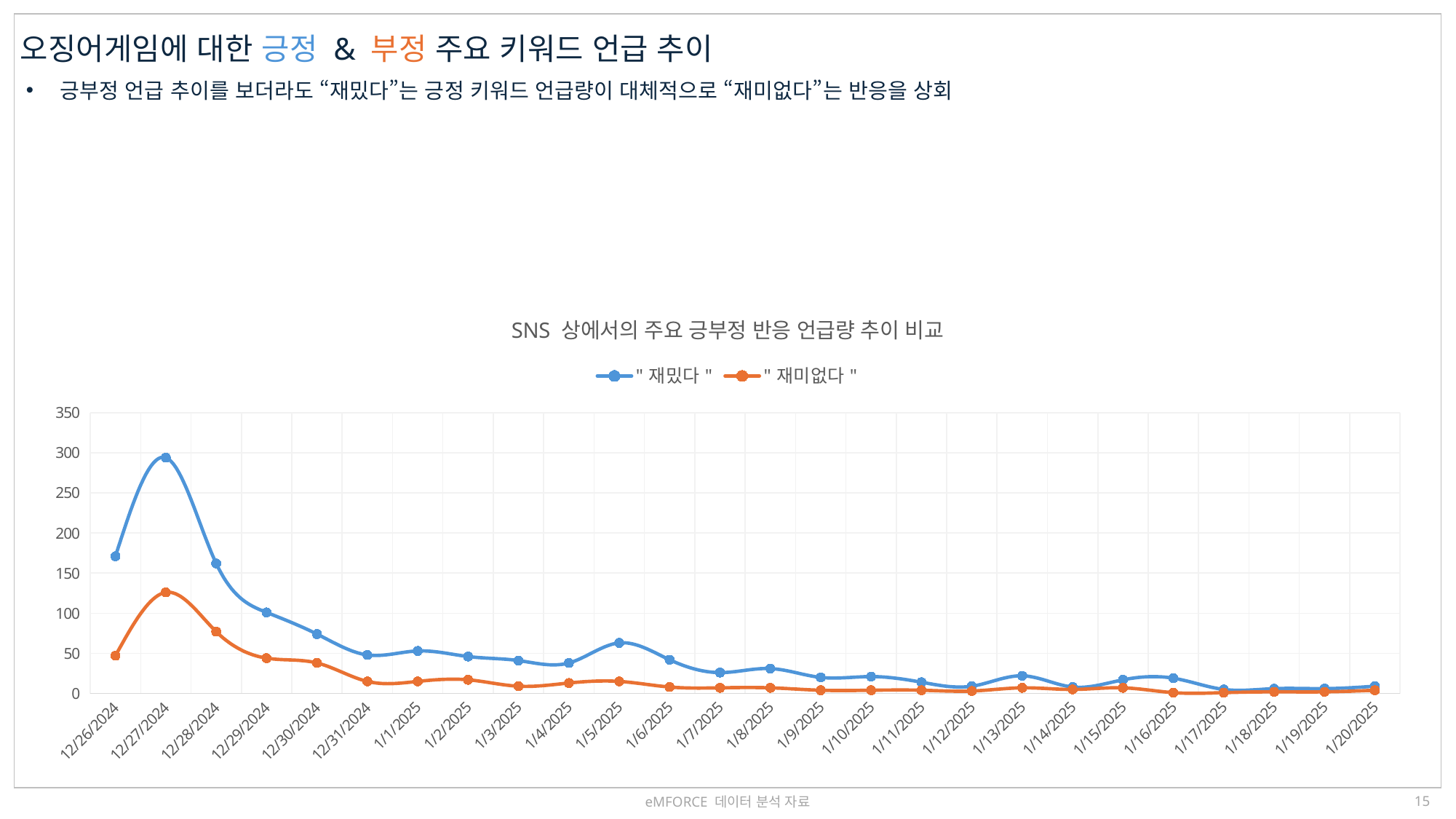
What is the title of the chart? SNS 상에서의 주요 긍부정 반응 언급량 추이 비교 Does the "재밌다" series generally rise or fall from 12/27/2024 to 1/20/2025? fall Is the value for "재미없다" on 12/27/2024 greater or less than 150? less Is the value for "재밌다" on 12/27/2024 greater or less than 250? greater What kind of chart is shown on the slide? line chart Which colour is used for the "재미없다" series? orange On which date does the "재미없다" series reach its highest value? 12/27/2024 Is the value for "재밌다" on 12/26/2024 greater or less than 150? greater How many series does the legend list? 2 On which date does the "재밌다" series reach its highest value? 12/27/2024 Which series has the larger value on 12/28/2024, "재밌다" or "재미없다"? 재밌다 How many dates are plotted along the x axis? 26